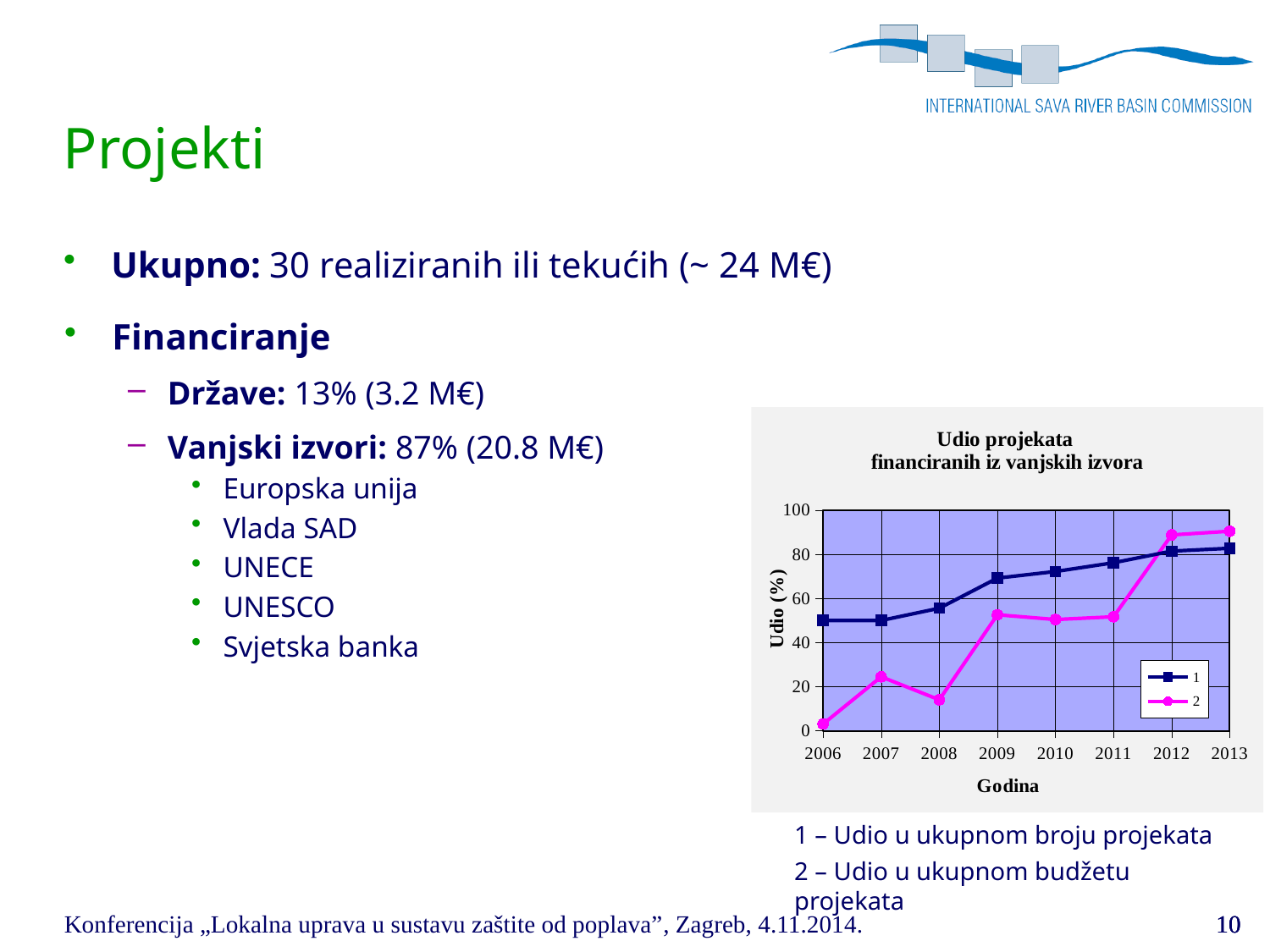
Is the value for series 2 in 2006 greater or less than 20? less What kind of chart is shown on the slide? line chart In 2006, which series has the larger value, series 1 or series 2? series 1 Is the value for series 2 in 2012 greater or less than 80? greater Is the value for series 2 in 2008 greater or less than 20? less How many years are shown on the x axis of the chart? 8 How many series does the chart legend list? 2 In which year does series 2 have its lowest value? 2006 Does series 1 generally rise or fall from 2006 to 2013? rise In 2013, which series has the larger value, series 1 or series 2? series 2